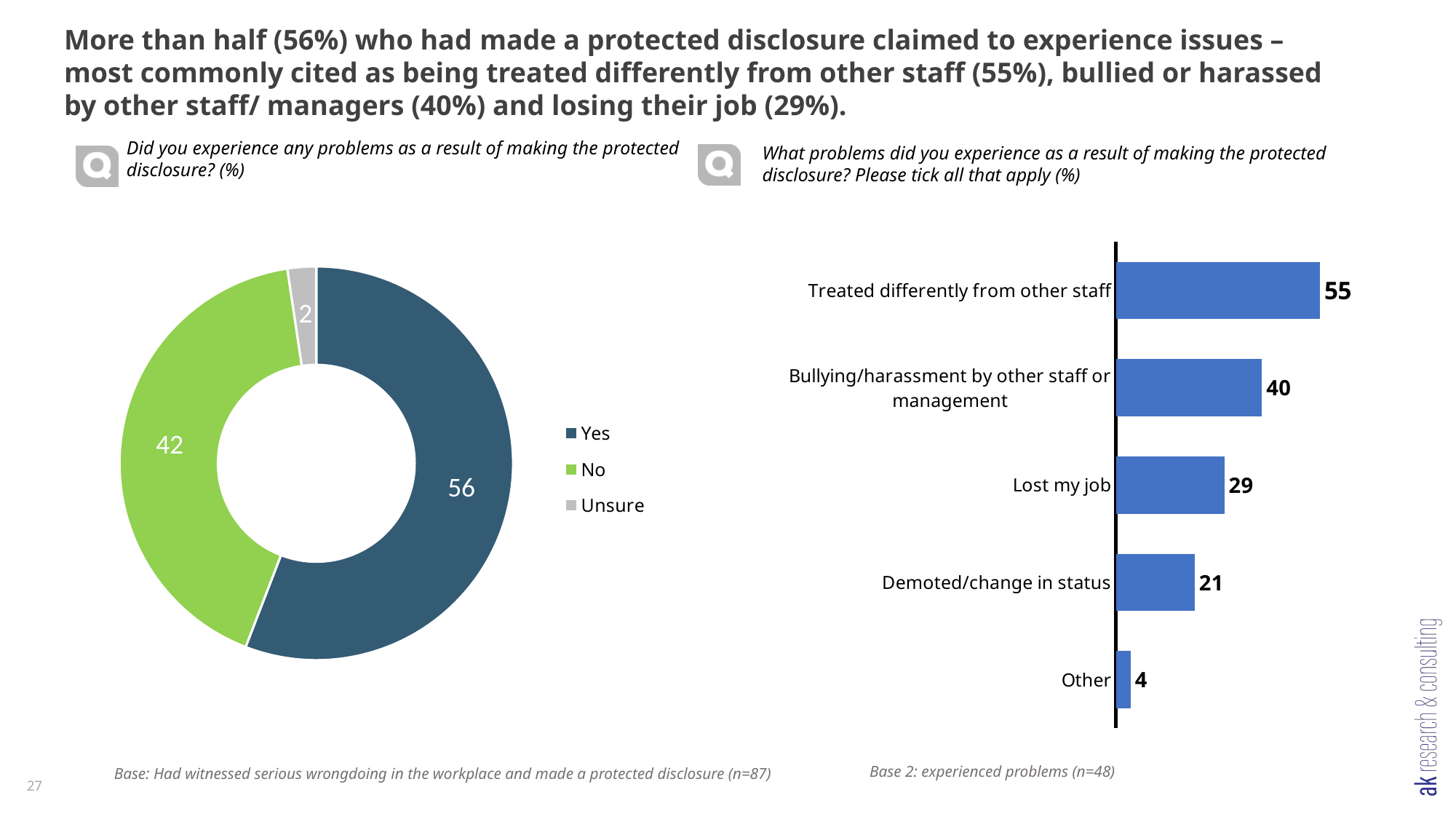
In the left-hand doughnut chart, what is the difference between the Yes and No shares? 14 In the right-hand bar chart, which problem has the lowest value? Other In the left-hand doughnut chart, what percentage answered No? 42 In the left-hand doughnut chart, which response has the smallest share? Unsure In the right-hand bar chart, which problem has the highest value? Treated differently from other staff In the left-hand doughnut chart, what percentage answered Unsure? 2 In the left-hand doughnut chart, how many entries does the legend list? 3 In the right-hand bar chart, what is the value for Demoted/change in status? 21 In the right-hand bar chart, what is the difference between Treated differently from other staff and Bullying/harassment by other staff or management? 15 In the right-hand bar chart, what is the value for Lost my job? 29 In the left-hand doughnut chart, what percentage answered Yes? 56 In the right-hand bar chart, how many categories are shown? 5